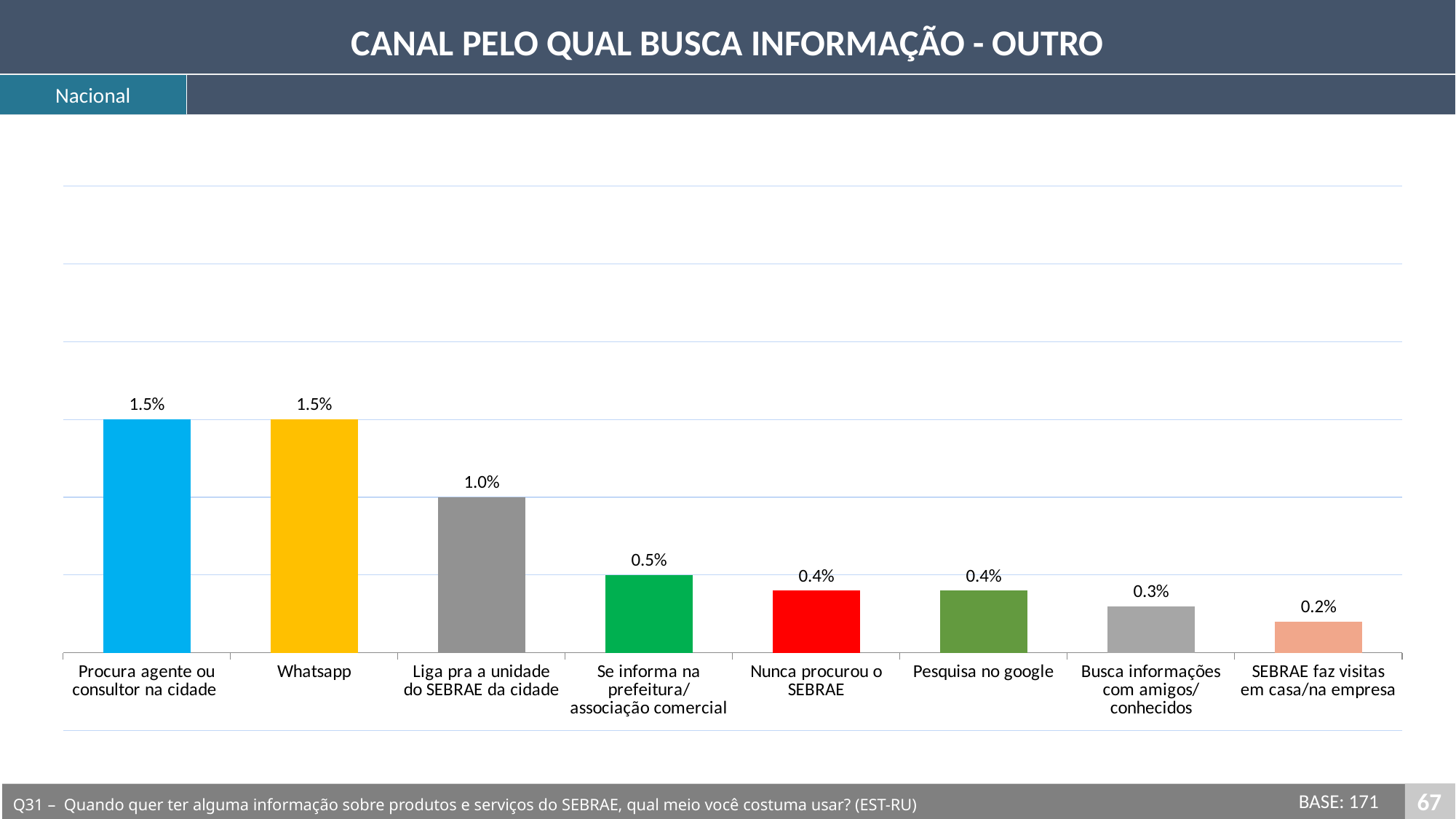
Which category has the lowest value? SEBRAE faz visitas em casa/na empresa How many categories are shown in the chart? 8 What is the value for "Pesquisa no google"? 0.4% Do the values rise or fall from left to right along the x axis? Fall What is the difference between the value for Whatsapp and the value for "Liga pra a unidade do SEBRAE da cidade"? 0.5% What is the title of the slide? CANAL PELO QUAL BUSCA INFORMAÇÃO - OUTRO What is the difference between the value for "Liga pra a unidade do SEBRAE da cidade" and the value for "SEBRAE faz visitas em casa/na empresa"? 0.8% Which is larger: the value for Whatsapp or the value for "Pesquisa no google"? Whatsapp What is the value for Whatsapp? 1.5% What kind of chart is shown on the slide? Bar chart What is the value for "Busca informações com amigos/conhecidos"? 0.3% What is the value for "Liga pra a unidade do SEBRAE da cidade"? 1.0%